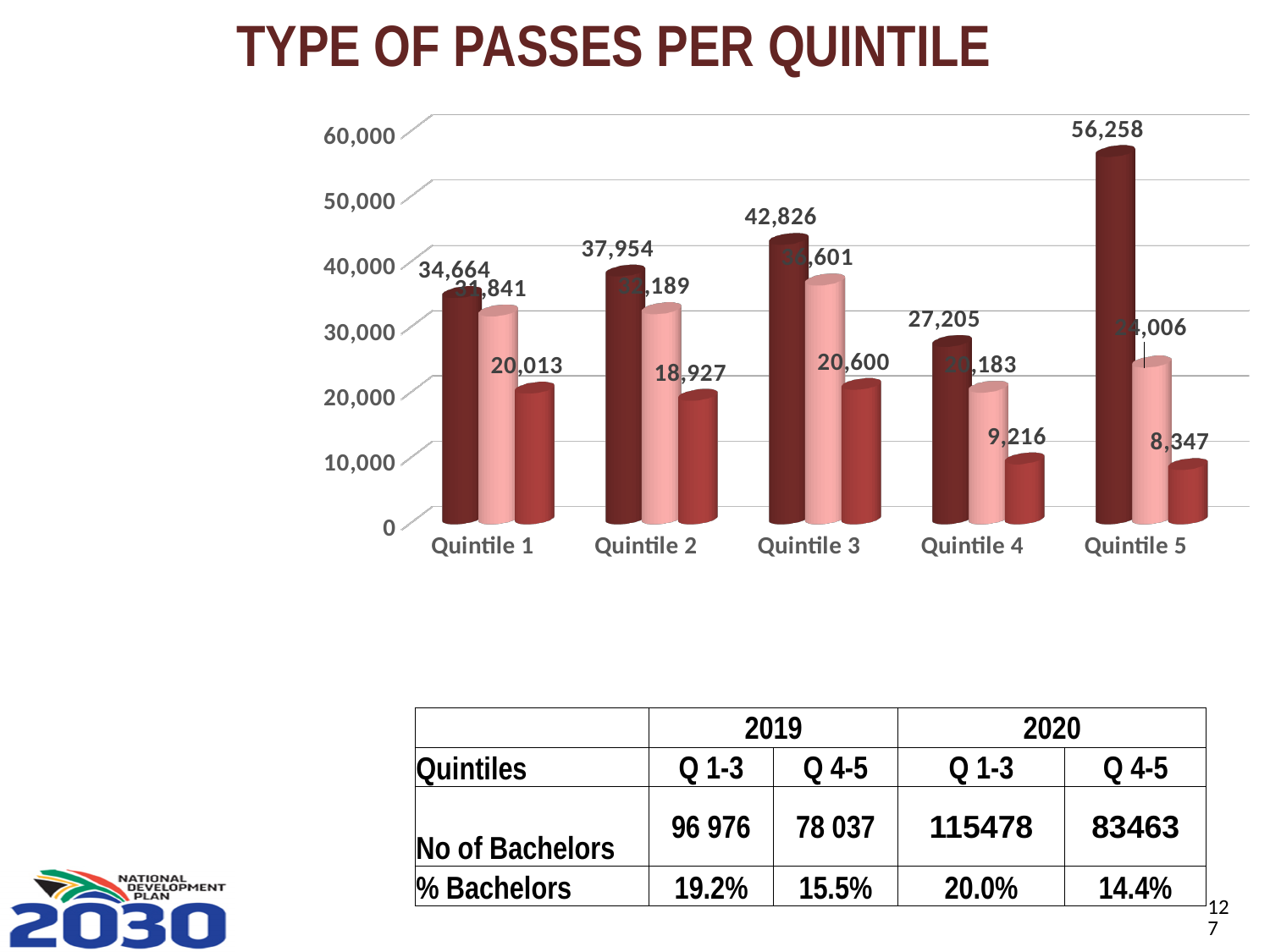
What is the value of the third (red, rightmost) bar for Quintile 3? 20,600 Is the value of the first (dark red) bar for Quintile 4 greater or less than 30,000? less What is the value of the tallest (dark red, first) bar for Quintile 5? 56,258 What is the title of the slide containing the chart? TYPE OF PASSES PER QUINTILE What is the difference between the first (dark red) bar and the third (red) bar for Quintile 1? 14,651 Which quintile has the highest value for the first (dark red) bar? Quintile 5 How many quintile categories are shown on the x axis of the chart? 5 What is the value of the third (red, rightmost) bar for Quintile 4? 9,216 Which quintile has the lowest value for the third (red, rightmost) bar in each group? Quintile 5 What is the difference between the first (dark red) bar and the third (red) bar for Quintile 5? 47,911 Which is larger: the first (dark red) bar for Quintile 2 or for Quintile 3? Quintile 3 What kind of chart is shown on the slide? bar chart